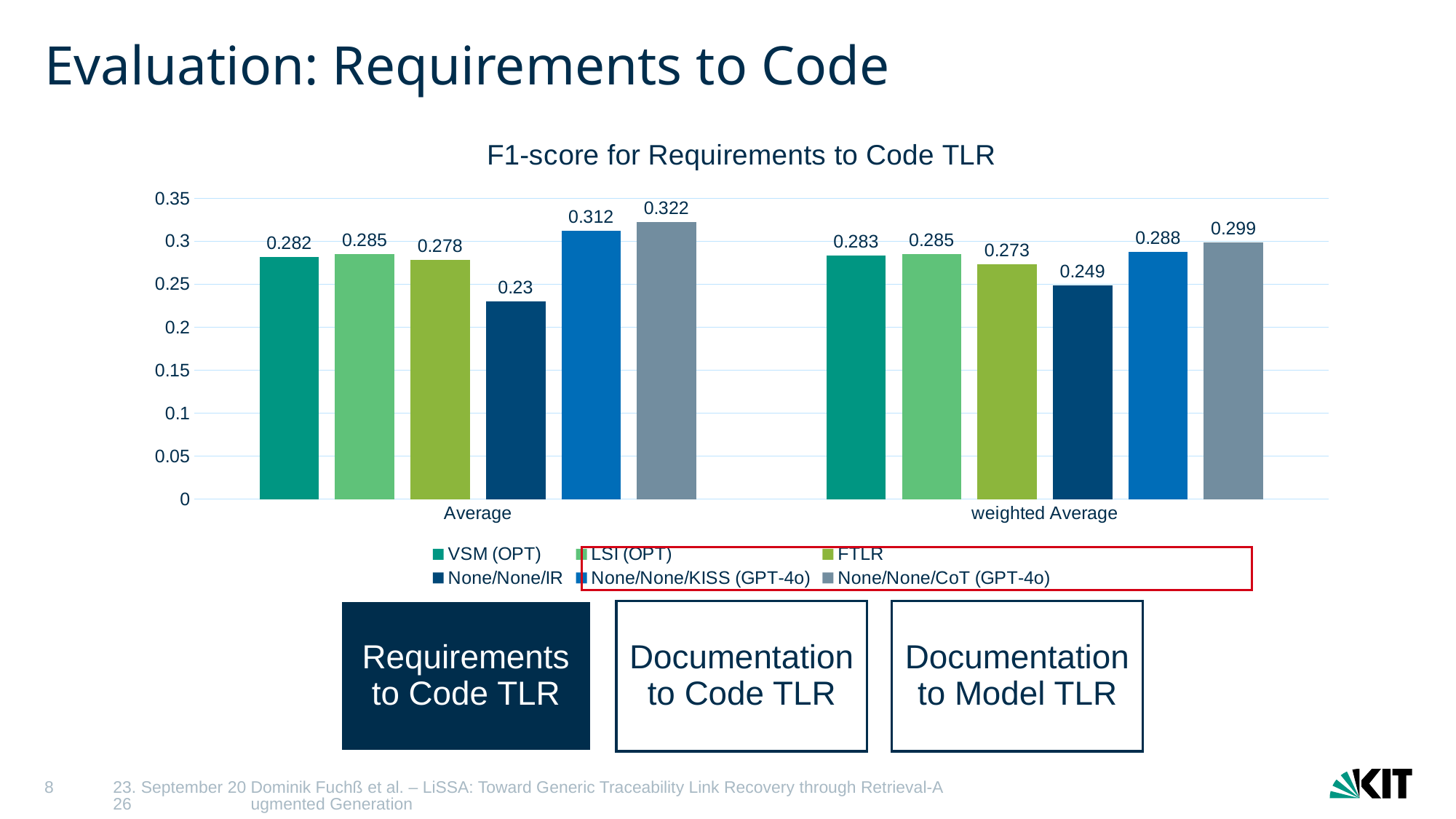
How many categories are shown on the x axis? 2 What is the F1-score of FTLR for Average? 0.278 What is the difference between the F1-scores of None/None/CoT (GPT-4o) and None/None/IR for Average? 0.092 Is the F1-score of None/None/IR for Average greater or less than 0.25? less What is the F1-score of None/None/CoT (GPT-4o) for Average? 0.322 Which series has the highest F1-score for weighted Average? None/None/CoT (GPT-4o) How many series does the legend list? 6 What is the F1-score of None/None/IR for weighted Average? 0.249 Which is larger for weighted Average: the F1-score of None/None/KISS (GPT-4o) or of VSM (OPT)? None/None/KISS (GPT-4o) What is the title of the chart? F1-score for Requirements to Code TLR What type of chart is shown on the slide? bar chart Which series has the lowest F1-score for Average? None/None/IR